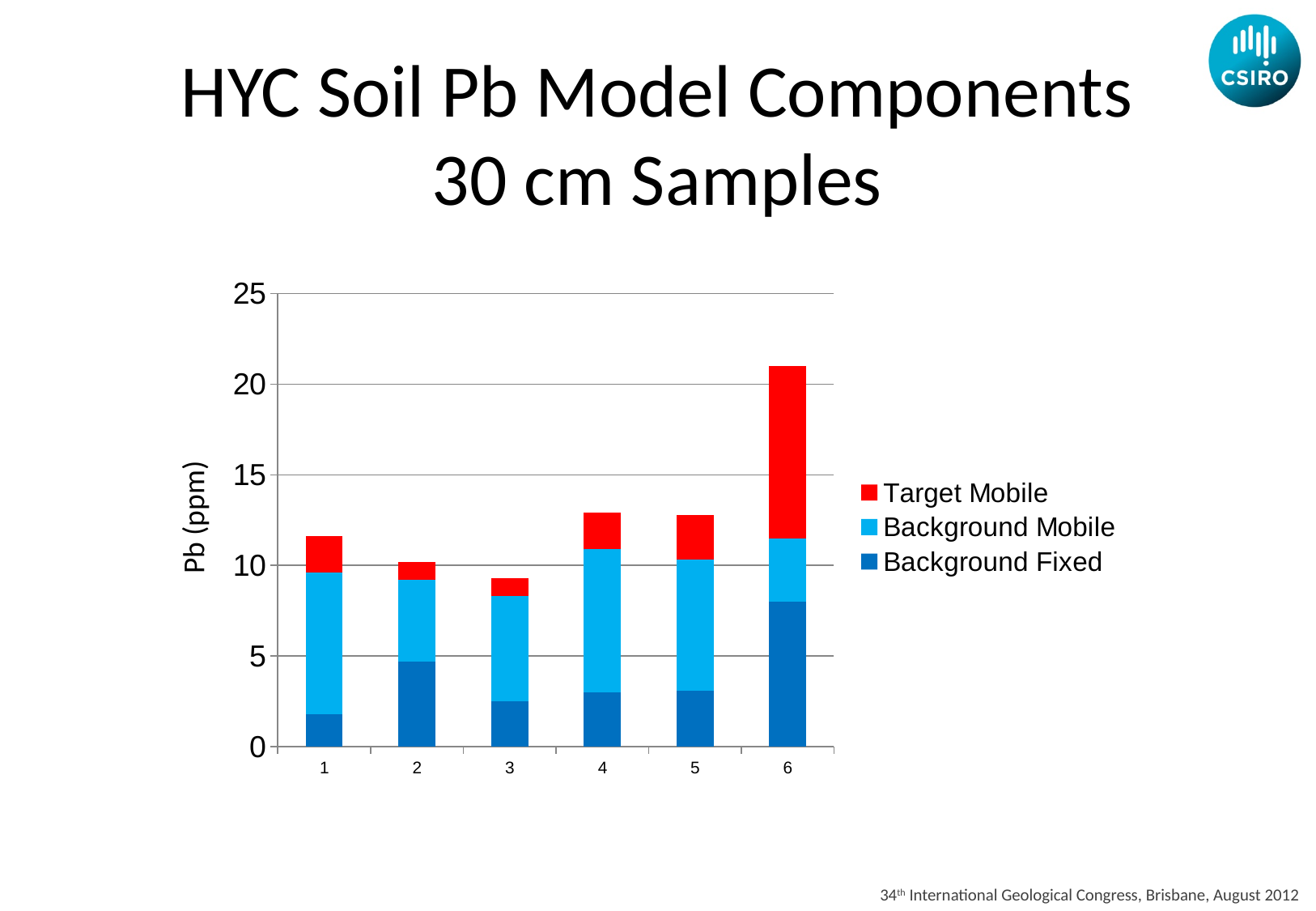
What kind of chart is shown on the slide? stacked bar chart What is the label of the y axis? Pb (ppm) Which sample has the lowest total Pb (ppm)? 3 Is the total Pb value for sample 6 greater or less than 20? greater Which sample has the largest Target Mobile component? 6 Which has the larger total Pb, sample 1 or sample 6? 6 Which sample has the largest Background Fixed component? 6 Which sample has the highest total Pb (ppm)? 6 Which sample has the smallest Background Fixed component? 1 How many series does the legend list? 3 How many sample categories are shown on the x axis? 6 Is the total Pb value for sample 3 greater or less than 10? less